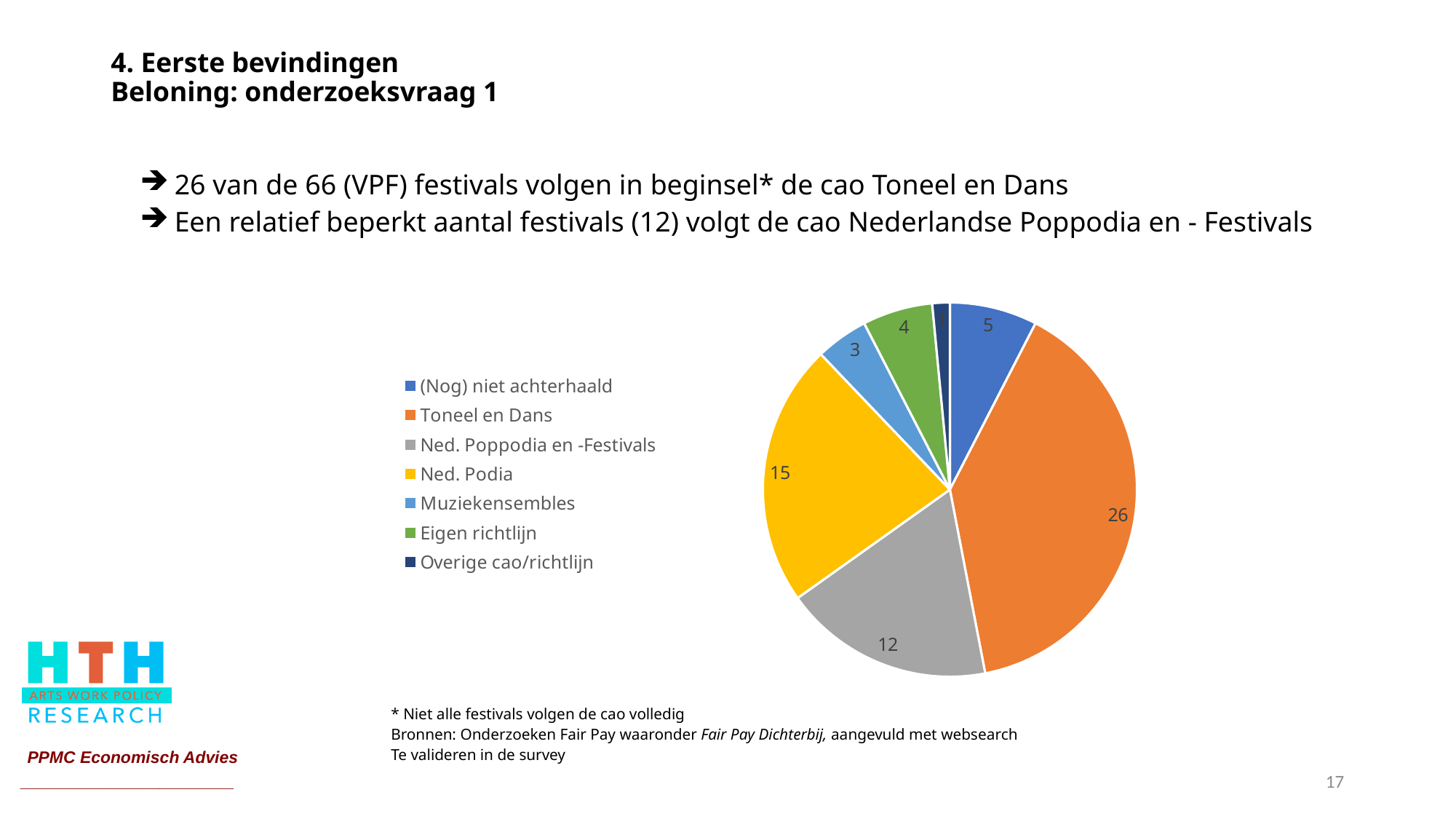
What is the total of all the values shown in the pie chart? 66 What is the difference between the values for Toneel en Dans and Ned. Podia? 11 Which is larger, the value for Eigen richtlijn or the value for (Nog) niet achterhaald? (Nog) niet achterhaald How many categories does the pie chart show? 7 Which category has the smallest slice in the pie chart? Overige cao/richtlijn Which category has the largest slice in the pie chart? Toneel en Dans What is the value for Toneel en Dans in the pie chart? 26 What is the value for Muziekensembles in the pie chart? 3 What is the value for Ned. Poppodia en -Festivals in the pie chart? 12 What kind of chart is shown on the slide? pie chart What is the value for Ned. Podia in the pie chart? 15 Which colour represents Ned. Podia in the pie chart? yellow